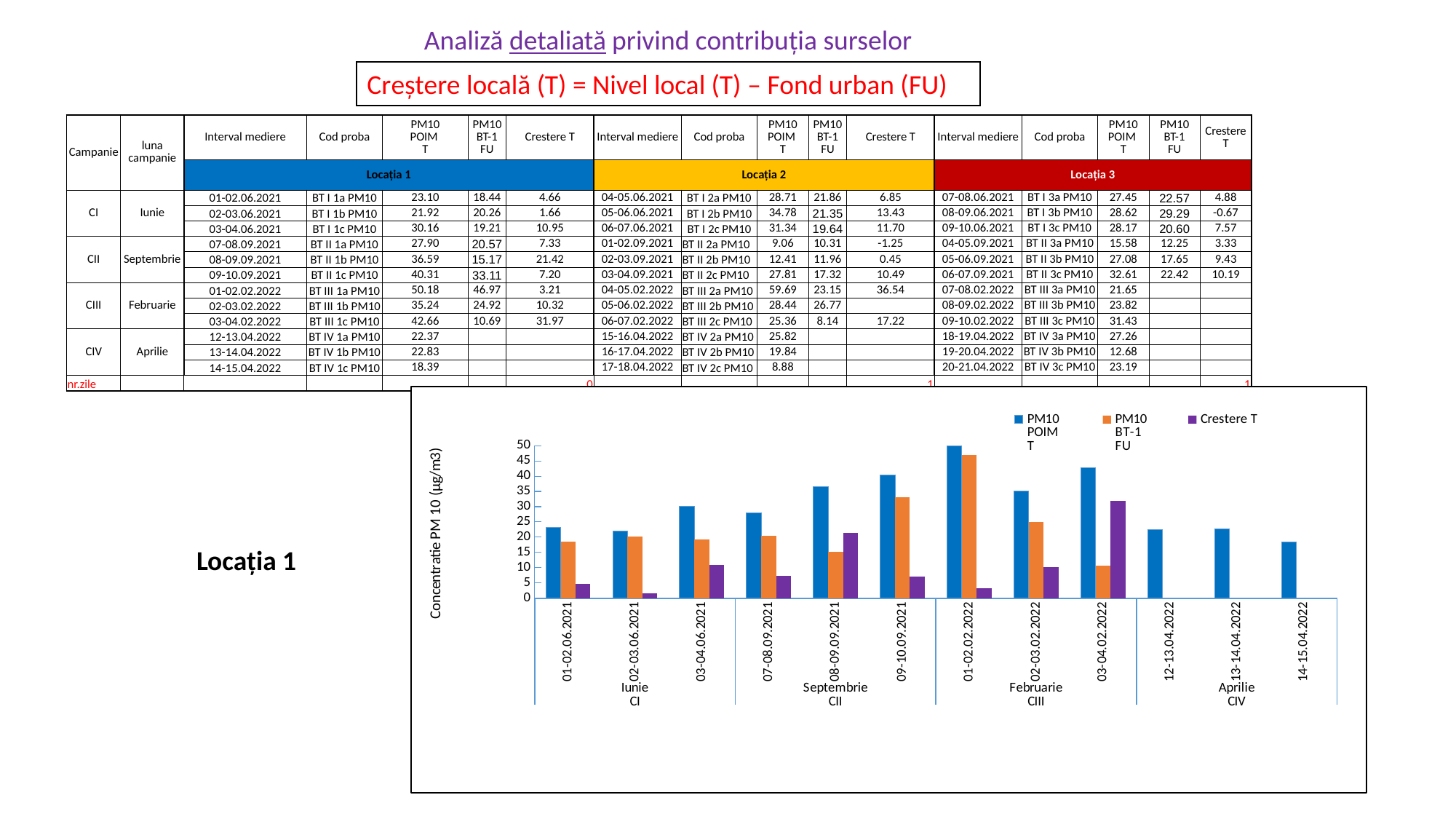
For 03-04.06.2021, which is larger: PM10 POIM T or PM10 BT-1 FU? PM10 POIM T What kind of chart is shown on the slide? bar chart How many series does the chart legend list? 3 What is the label of the chart's vertical axis? Concentratie PM 10 (µg/m3) Is the PM10 BT-1 FU value for 08-09.09.2021 greater or less than 20? less Which date has the lowest PM10 POIM T bar in the chart? 14-15.04.2022 Is the PM10 POIM T value for 09-10.09.2021 greater or less than 35? greater Does the Crestere T value rise or fall across the three Februarie (CIII) dates? rise Is the Crestere T value for 03-04.02.2022 greater or less than 30? greater Which date has the highest Crestere T bar in the chart? 03-04.02.2022 How many date categories are plotted along the x axis of the chart? 12 Which date has the highest PM10 POIM T bar in the chart? 01-02.02.2022